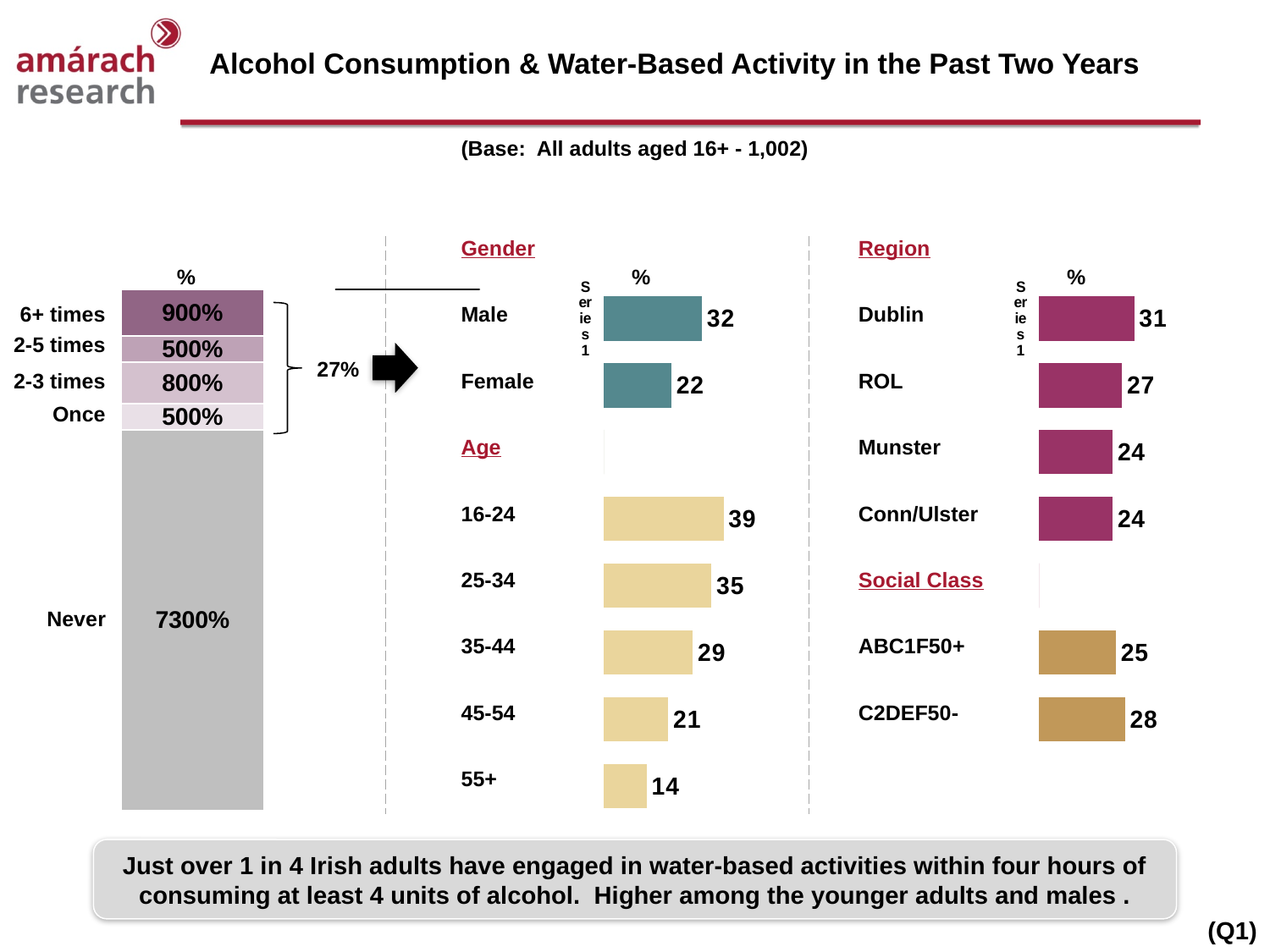
In the stacked bar chart on the left, what is the label shown for Never? 7300% In the Social Class chart, which is larger, ABC1F50+ or C2DEF50-? C2DEF50- In the Age chart, do the values rise or fall as the age groups get older? fall In the Gender chart, what is the value for Female? 22 In the Gender chart, what is the difference between the Male and Female values? 10 In the Gender chart, what is the value for Male? 32 In the Age chart, which age group has the lowest value? 55+ In the Region chart, how many regions are shown? 4 In the Age chart, which age group has the highest value? 16-24 In the Age chart, what is the value for 35-44? 29 What kind of chart is the Age chart? bar chart In the Region chart, what is the value for Dublin? 31